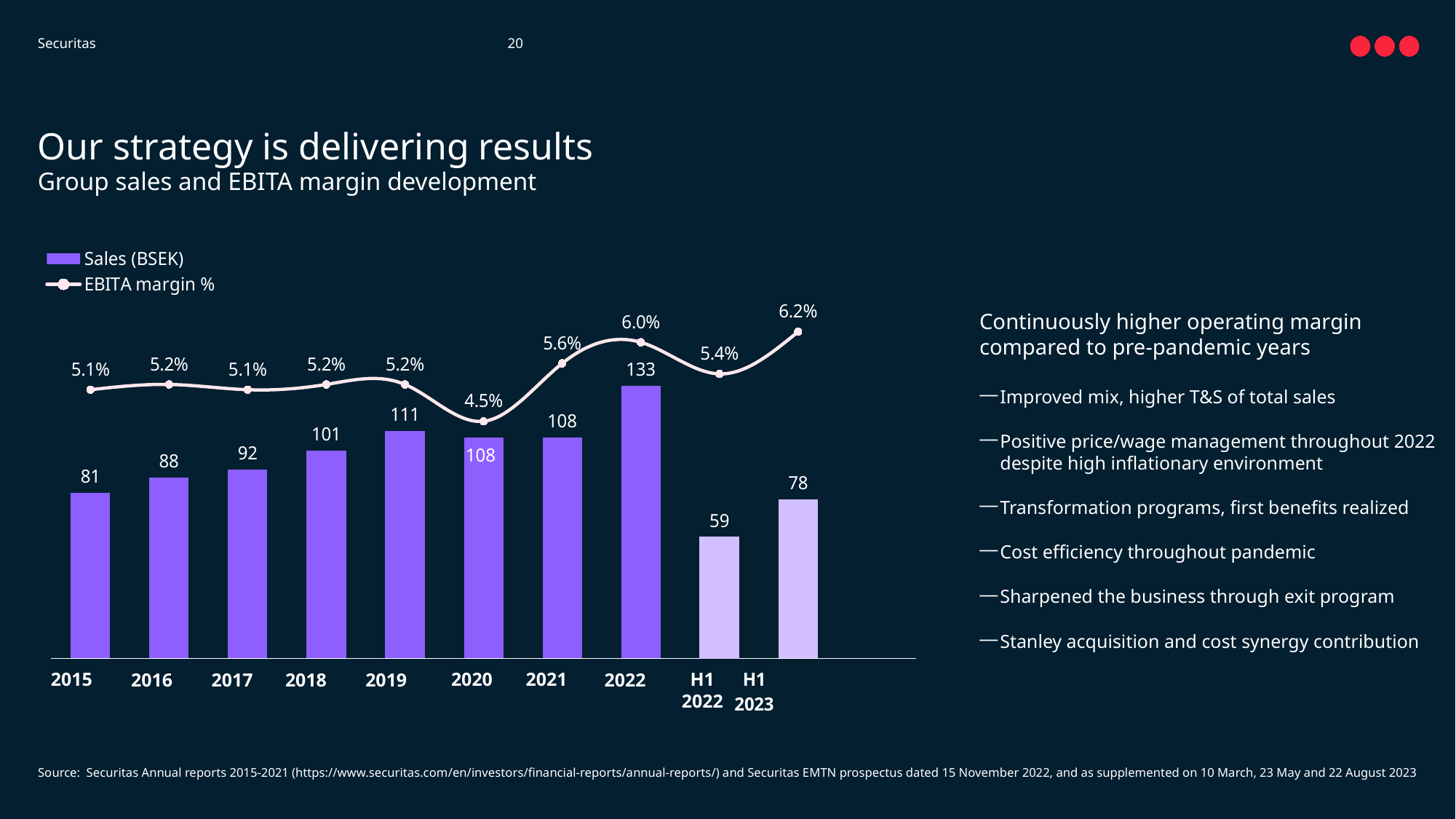
What was the EBITA margin % in 2020? 4.5% What was Sales (BSEK) in 2022? 133 Which is larger, Sales (BSEK) in 2019 or in 2021? 2019 How many periods are shown on the x axis? 10 Which period has the highest Sales (BSEK)? 2022 How many series does the legend list? 2 What kind of chart is used to show Sales (BSEK)? Bar chart What was Sales (BSEK) in H1 2023? 78 Which period has the lowest EBITA margin %? 2020 Did Sales (BSEK) rise or fall from 2015 to 2019? Rise What is the difference in Sales (BSEK) between H1 2023 and H1 2022? 19 What was the EBITA margin % in H1 2023? 6.2%